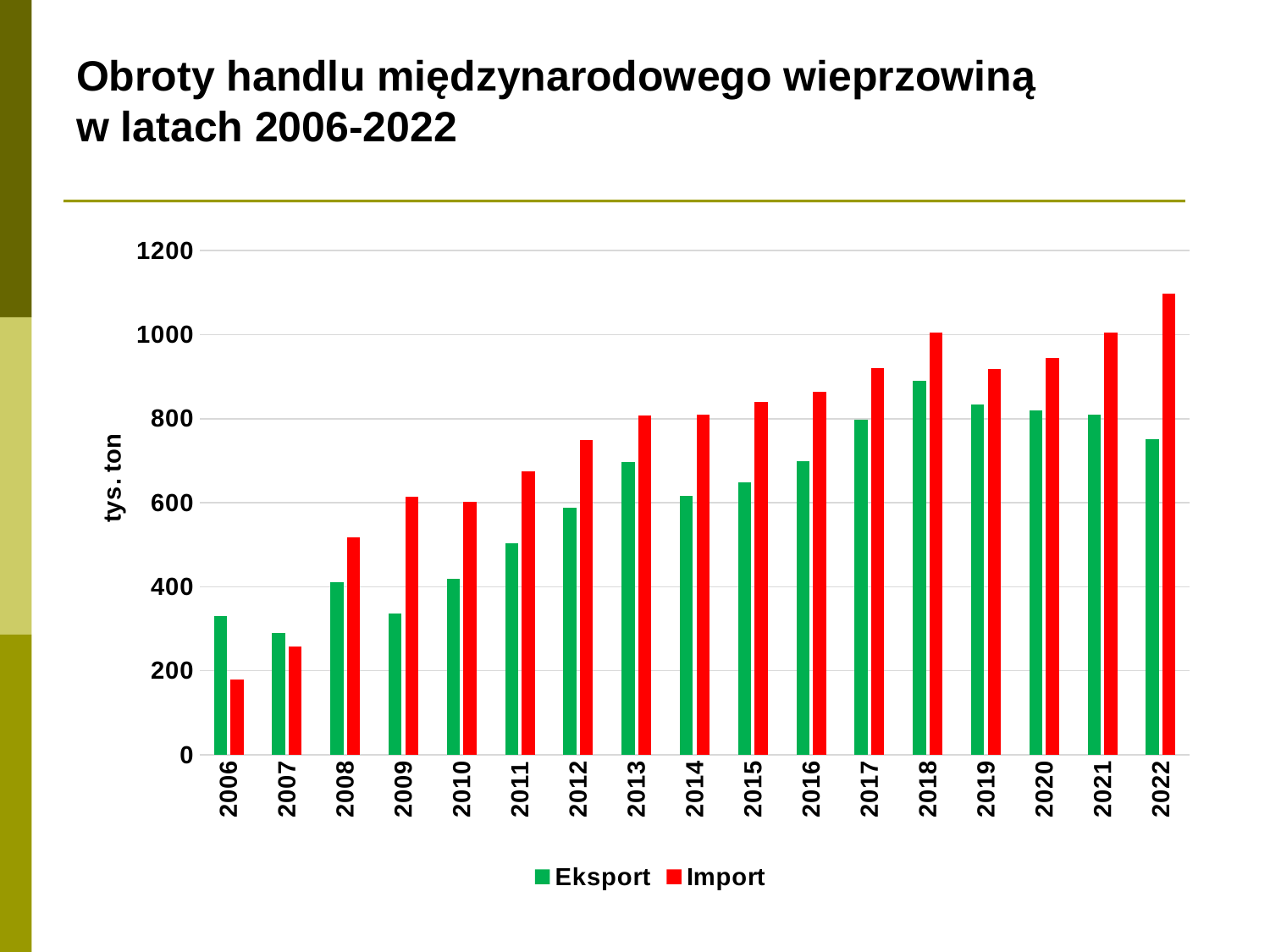
Is the Import value for 2006 greater or less than 200? less How many series does the legend list? 2 In which year is the Import value lowest? 2006 In 2006, which is larger, Eksport or Import? Eksport Is the Eksport value for 2018 greater or less than 800? greater What kind of chart is shown on the slide? bar chart In which year is the Eksport value highest? 2018 What is the label on the vertical axis? tys. ton How many years are shown on the x axis? 17 Does the Import series generally rise or fall from 2006 to 2022? rise In which year is the Import value highest? 2022 Is the Import value for 2022 greater or less than 1000? greater